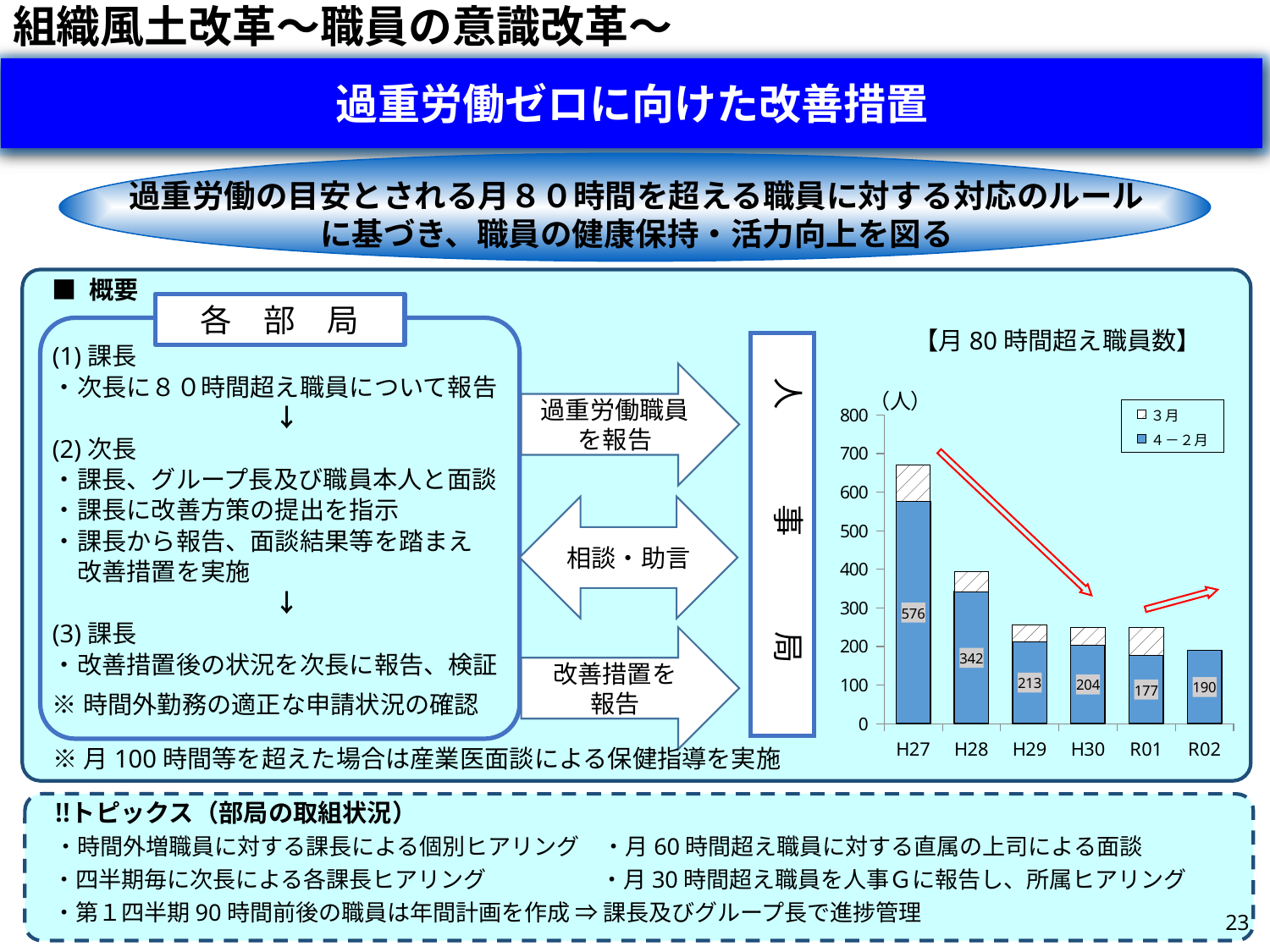
How many series does the chart legend list? 2 Which year has the lowest 4－2月 value in the chart? R01 Which is larger, the 4－2月 value for H29 or for H30? H29 Is the total height of the H27 bar greater or less than 600? greater What is the value of the 4－2月 series for H28 in the chart? 342 What is the difference between the 4－2月 values for H27 and H28? 234 Which year has the highest 4－2月 value in the chart? H27 Do the 4－2月 values rise or fall from H27 to R01? Fall What kind of chart is used to show 月80時間超え職員数? Stacked bar chart How many years are shown on the x axis of the chart? 6 What is the value of the 4－2月 series for H27 in the 【月80時間超え職員数】 chart? 576 What is the value of the 4－2月 series for R02 in the chart? 190